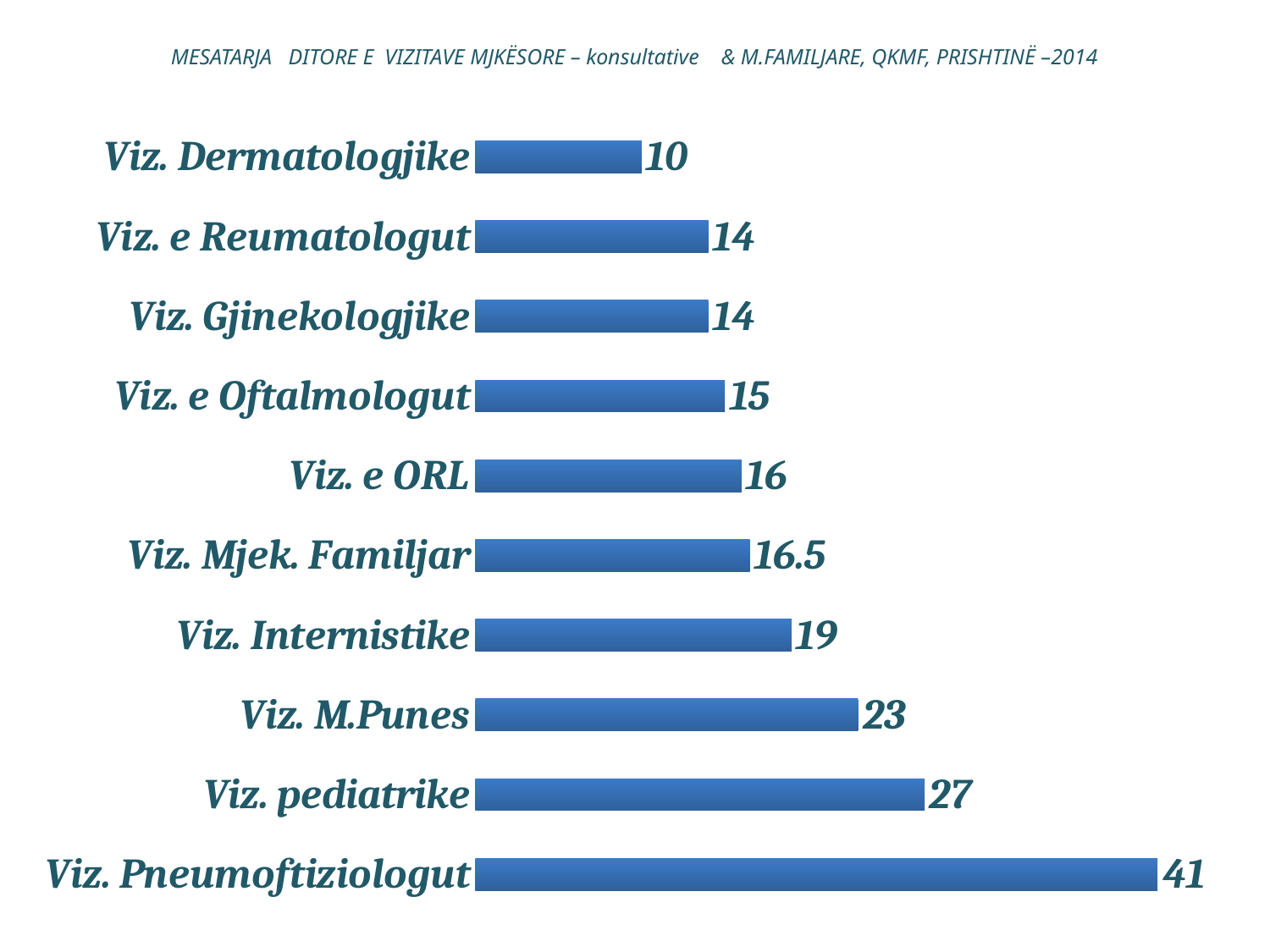
How many categories are shown in the chart? 10 Which category has the lowest value? Viz. Dermatologjike What is the value for Viz. M.Punes? 23 Which category has the highest value? Viz. Pneumoftiziologut Which two categories share the value 14? Viz. e Reumatologut and Viz. Gjinekologjike What is the value for Viz. Dermatologjike? 10 Which is larger, the value for Viz. M.Punes or the value for Viz. e Oftalmologut? Viz. M.Punes What is the difference between the values for Viz. Internistike and Viz. e ORL? 3 What is the difference between the values for Viz. Pneumoftiziologut and Viz. pediatrike? 14 What is the value for Viz. Mjek. Familjar? 16.5 What kind of chart is shown on the slide? Bar chart What is the value for Viz. Pneumoftiziologut? 41